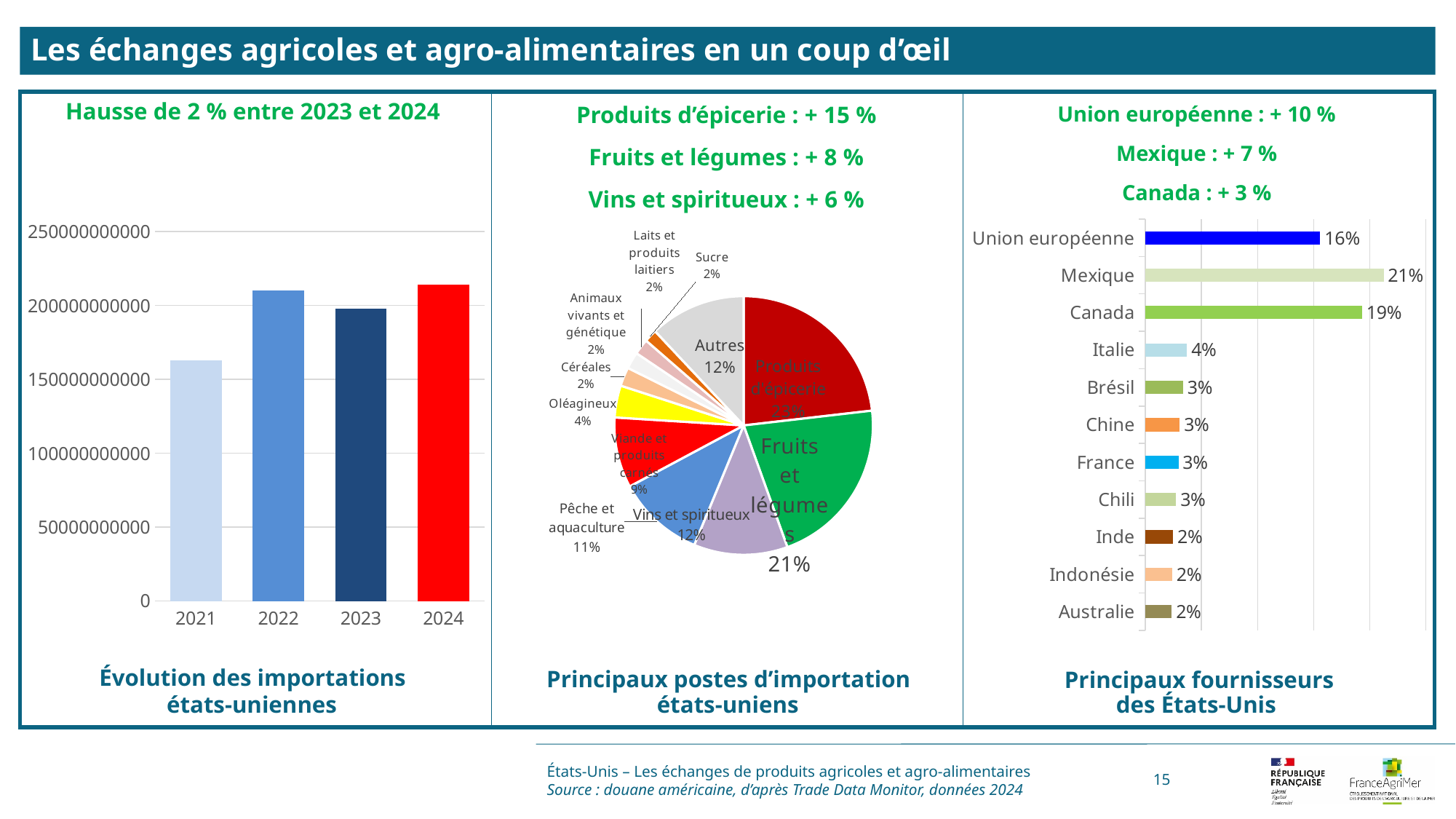
In the pie chart titled 'Principaux postes d'importation états-uniens', what is the difference between the shares of 'Produits d'épicerie' and 'Fruits et légumes'? 2 percentage points In the chart titled 'Principaux fournisseurs des États-Unis', what is the value for Italie? 4% In the pie chart titled 'Principaux postes d'importation états-uniens', what share does 'Produits d'épicerie' represent? 23% In the chart titled 'Principaux fournisseurs des États-Unis', how many suppliers are listed? 11 In the chart titled 'Évolution des importations états-uniennes', which year has the lowest value? 2021 In the pie chart titled 'Principaux postes d'importation états-uniens', which category has the largest share? Produits d'épicerie In the chart titled 'Principaux fournisseurs des États-Unis', which supplier has the highest share? Mexique In the chart titled 'Principaux fournisseurs des États-Unis', what is the difference between the values for Mexique and Canada? 2 percentage points In the chart titled 'Évolution des importations états-uniennes', is the value for 2022 greater or less than 200000000000? greater In the chart titled 'Principaux fournisseurs des États-Unis', what is the value for Mexique? 21% What kind of chart is 'Évolution des importations états-uniennes'? Bar chart In the pie chart titled 'Principaux postes d'importation états-uniens', what is the share for 'Pêche et aquaculture'? 11%